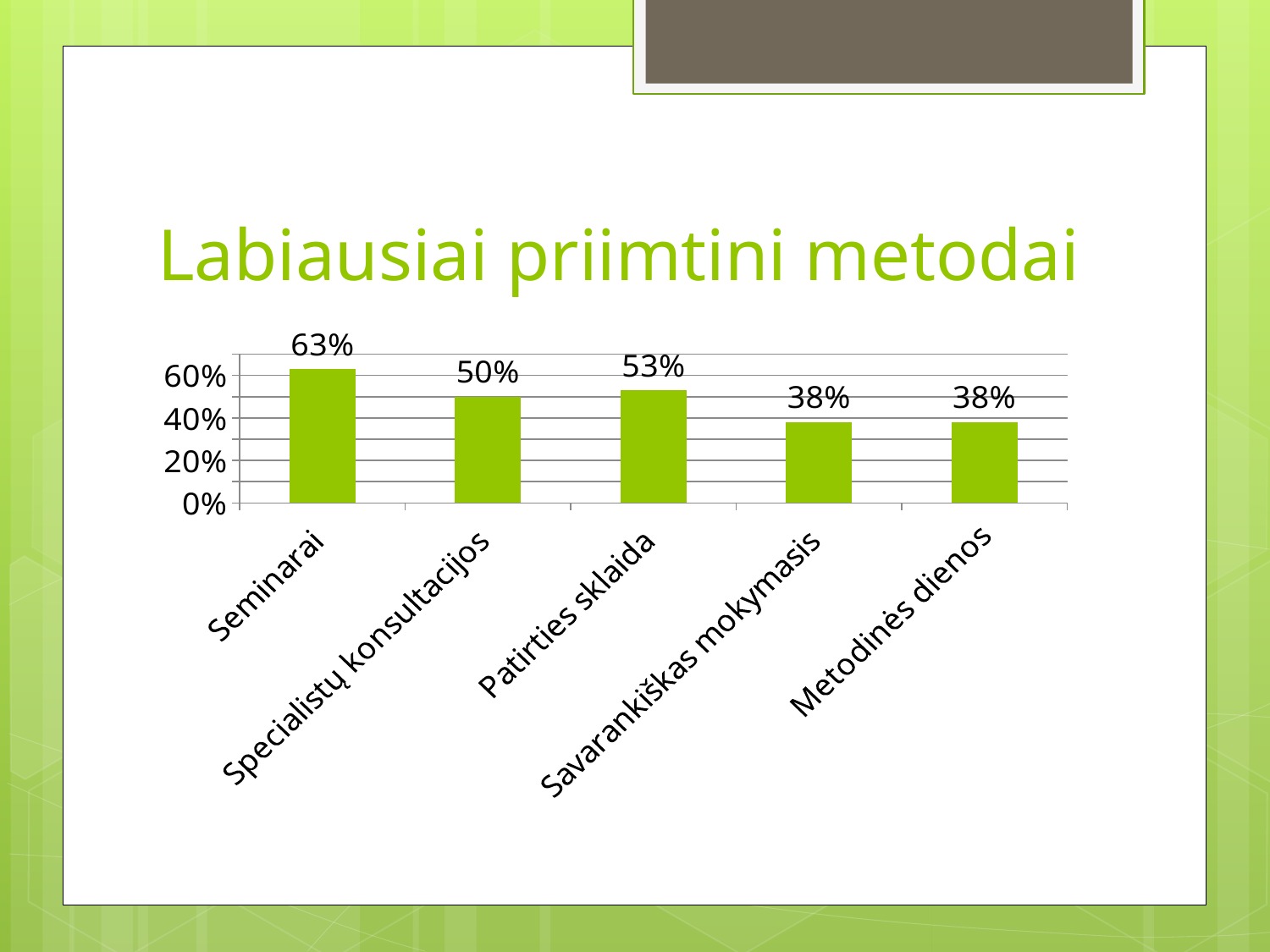
What is the difference between the values for Patirties sklaida and Specialistų konsultacijos? 3% What is the value for Patirties sklaida? 53% What is the value for Specialistų konsultacijos? 50% Which category has the highest value? Seminarai What kind of chart is shown on the slide? bar chart What is the value for Savarankiškas mokymasis? 38% Is the value for Metodinės dienos greater or less than 40%? less What is the title of the slide? Labiausiai priimtini metodai Which is larger, the value for Patirties sklaida or the value for Specialistų konsultacijos? Patirties sklaida What is the value for Seminarai? 63% What is the difference between the values for Seminarai and Metodinės dienos? 25% How many categories are shown in the chart? 5